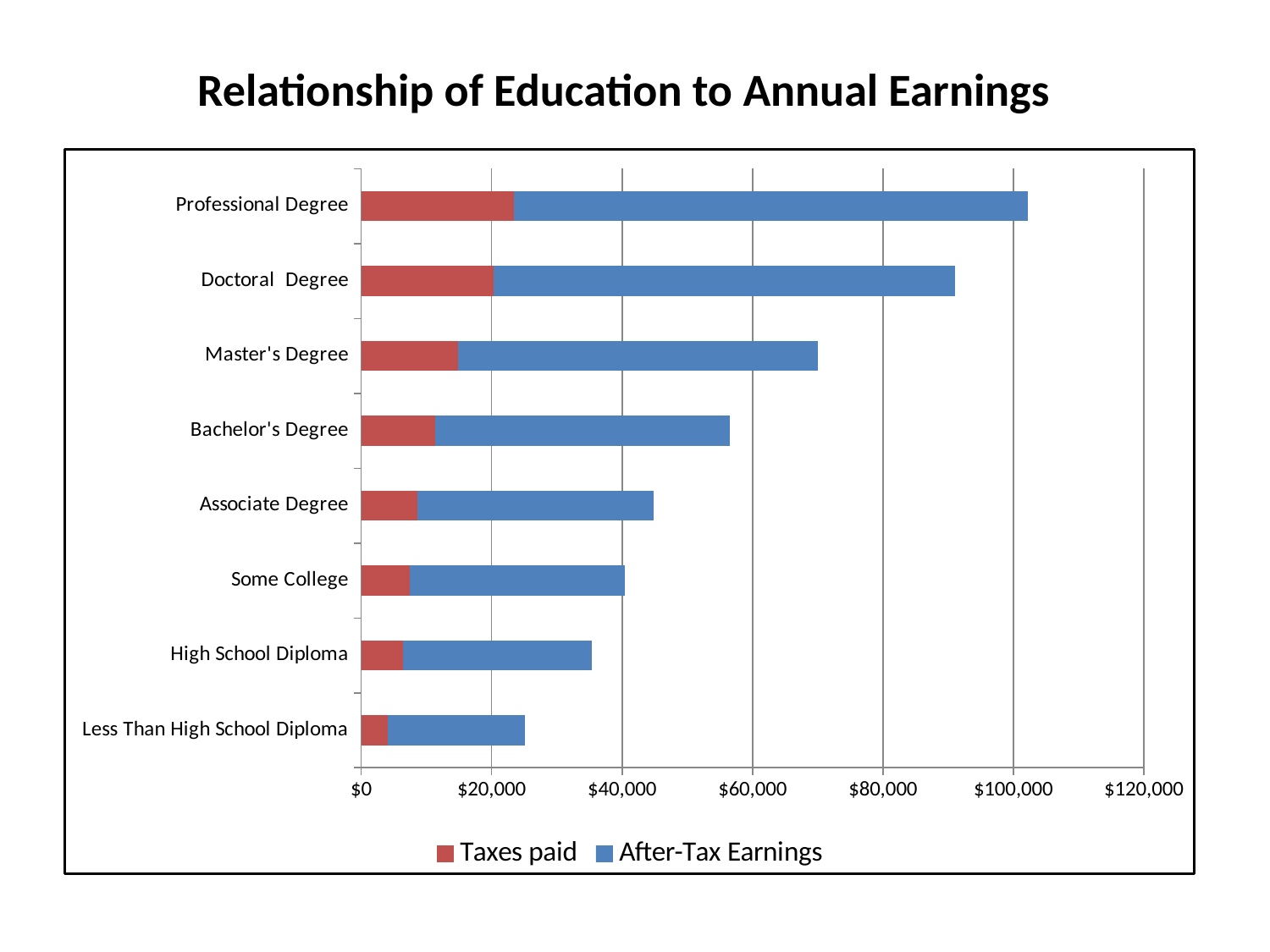
Is the Taxes paid value for Master's Degree greater or less than $20,000? less What are the two series named in the legend? Taxes paid and After-Tax Earnings Is the total bar for Bachelor's Degree greater or less than $60,000? less How many education categories are plotted on the chart? 8 Which education category has the shortest total bar? Less Than High School Diploma Which has a longer total bar, Professional Degree or Doctoral Degree? Professional Degree Which education category has the longest total bar? Professional Degree What kind of chart is shown on the slide? Stacked bar chart Is the total bar for Doctoral Degree greater or less than $80,000? greater What is the title of the chart? Relationship of Education to Annual Earnings How many series does the legend list? 2